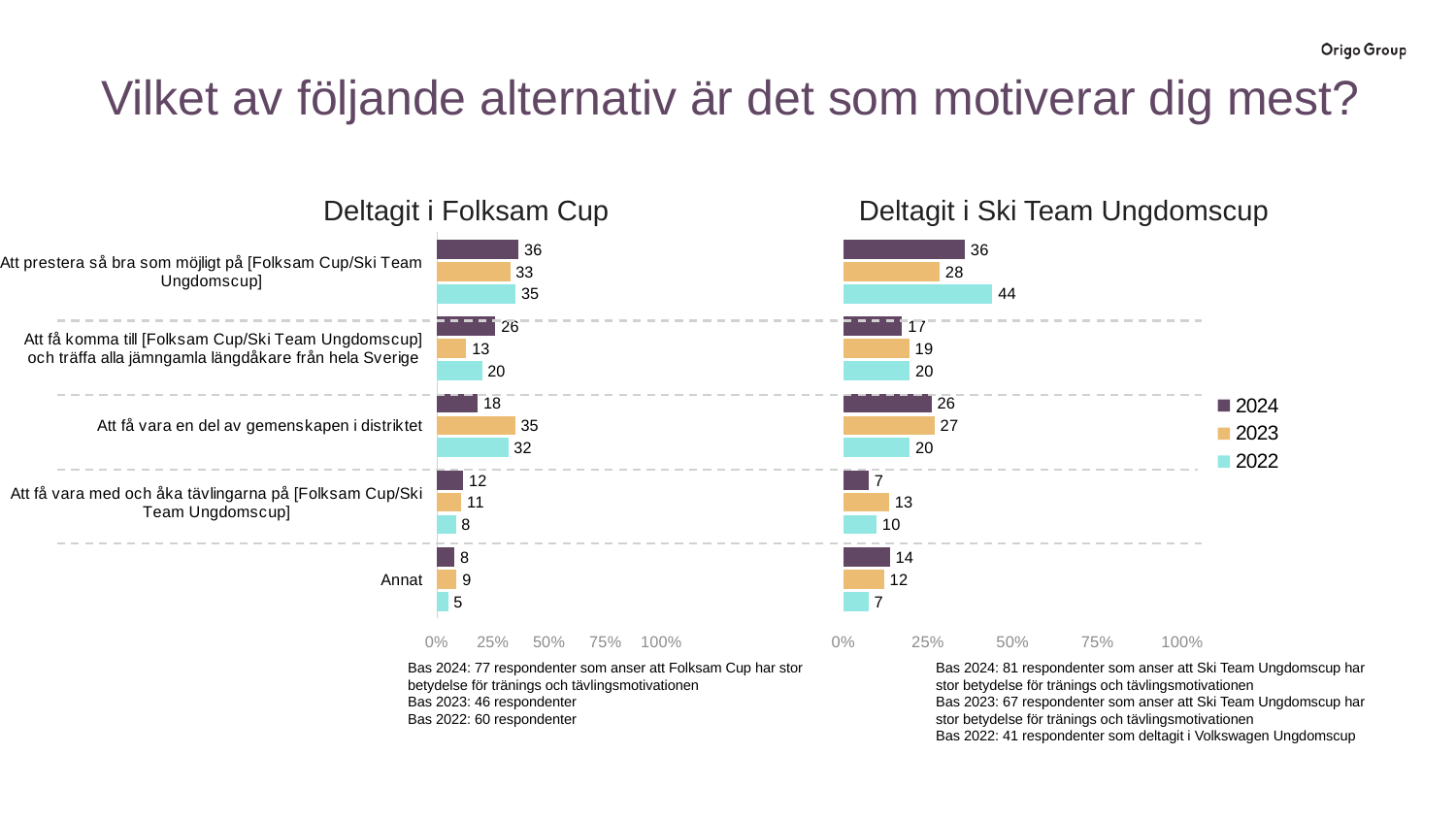
In the 'Deltagit i Folksam Cup' chart, which category has the highest 2024 value? Att prestera så bra som möjligt på [Folksam Cup/Ski Team Ungdomscup] In the 'Deltagit i Folksam Cup' chart, what is the 2023 value for 'Att få vara en del av gemenskapen i distriktet'? 35 In the 'Deltagit i Folksam Cup' chart, what is the difference between the 2024 and 2023 values for 'Att få komma till [Folksam Cup/Ski Team Ungdomscup] och träffa alla jämngamla längdåkare från hela Sverige'? 13 In the 'Deltagit i Ski Team Ungdomscup' chart, which is larger for 'Annat': the 2024 value or the 2022 value? 2024 In the 'Deltagit i Ski Team Ungdomscup' chart, which category has the lowest 2024 value? Att få vara med och åka tävlingarna på [Folksam Cup/Ski Team Ungdomscup] In the 'Deltagit i Folksam Cup' chart, what is the 2022 value for 'Annat'? 5 In the 'Deltagit i Ski Team Ungdomscup' chart, is the 2022 value for 'Att prestera så bra som möjligt på [Folksam Cup/Ski Team Ungdomscup]' greater or less than 25%? greater What type of chart is 'Deltagit i Ski Team Ungdomscup'? Bar chart How many series does the legend list for the charts on this slide? 3 How many categories are shown in the 'Deltagit i Folksam Cup' chart? 5 In the 'Deltagit i Ski Team Ungdomscup' chart, what is the 2022 value for 'Att prestera så bra som möjligt på [Folksam Cup/Ski Team Ungdomscup]'? 44 In the 'Deltagit i Folksam Cup' chart, what is the 2024 value for 'Att prestera så bra som möjligt på [Folksam Cup/Ski Team Ungdomscup]'? 36